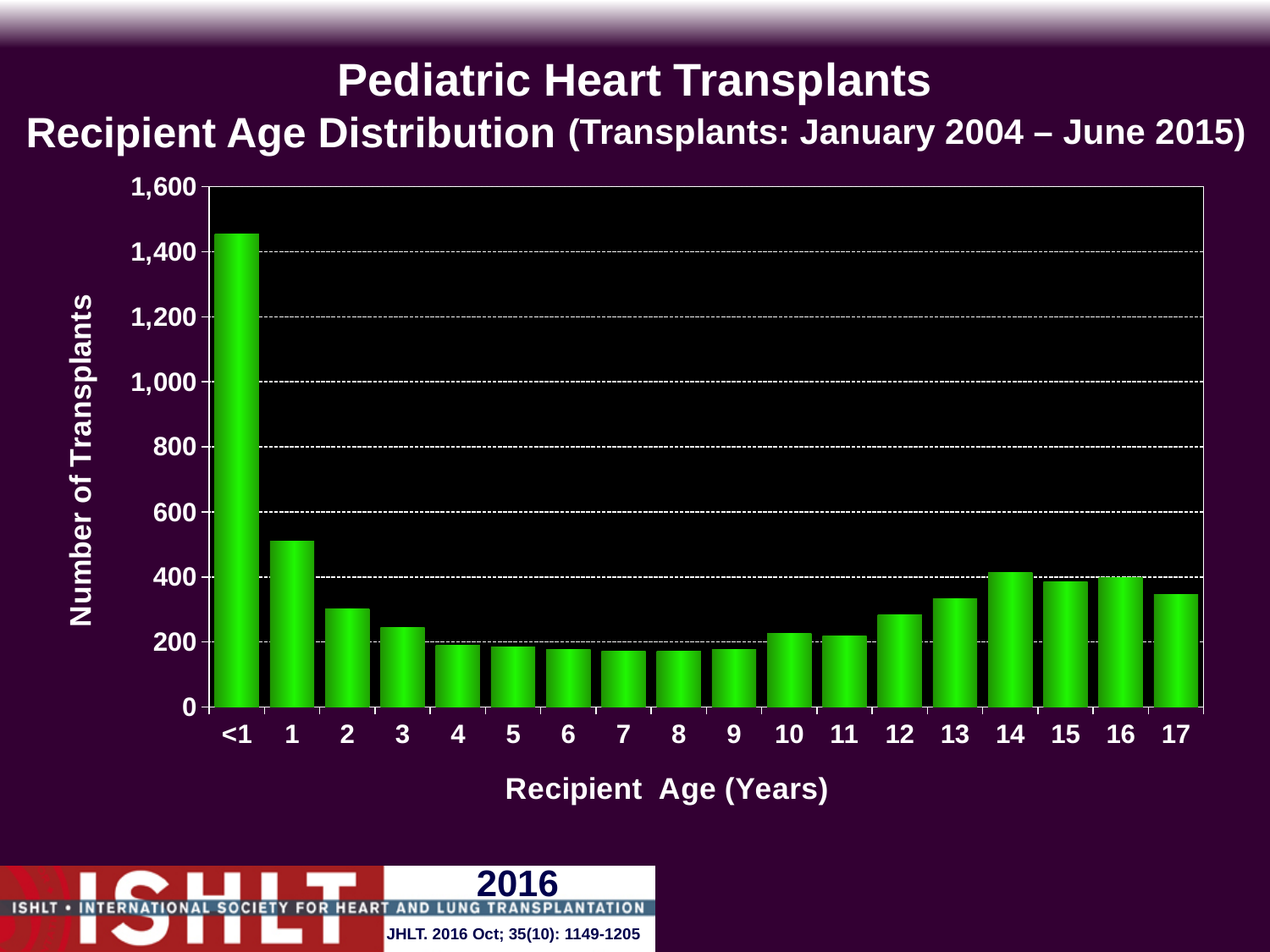
How many recipient age categories are shown on the x axis? 18 Which recipient age group has the highest number of transplants? <1 Do the number of transplants rise or fall from age 1 to age 7? fall Is the number of transplants for recipients aged 1 greater or less than 400? greater Which has more transplants: recipients aged 2 or recipients aged 3? 2 Is the number of transplants for recipients aged 13 greater or less than 400? less What kind of chart is shown on the slide? bar chart Do the number of transplants rise or fall from age 9 to age 14? rise What is the label of the y axis? Number of Transplants Is the number of transplants for recipients aged 7 greater or less than 200? less Which has more transplants: recipients aged 14 or recipients aged 13? 14